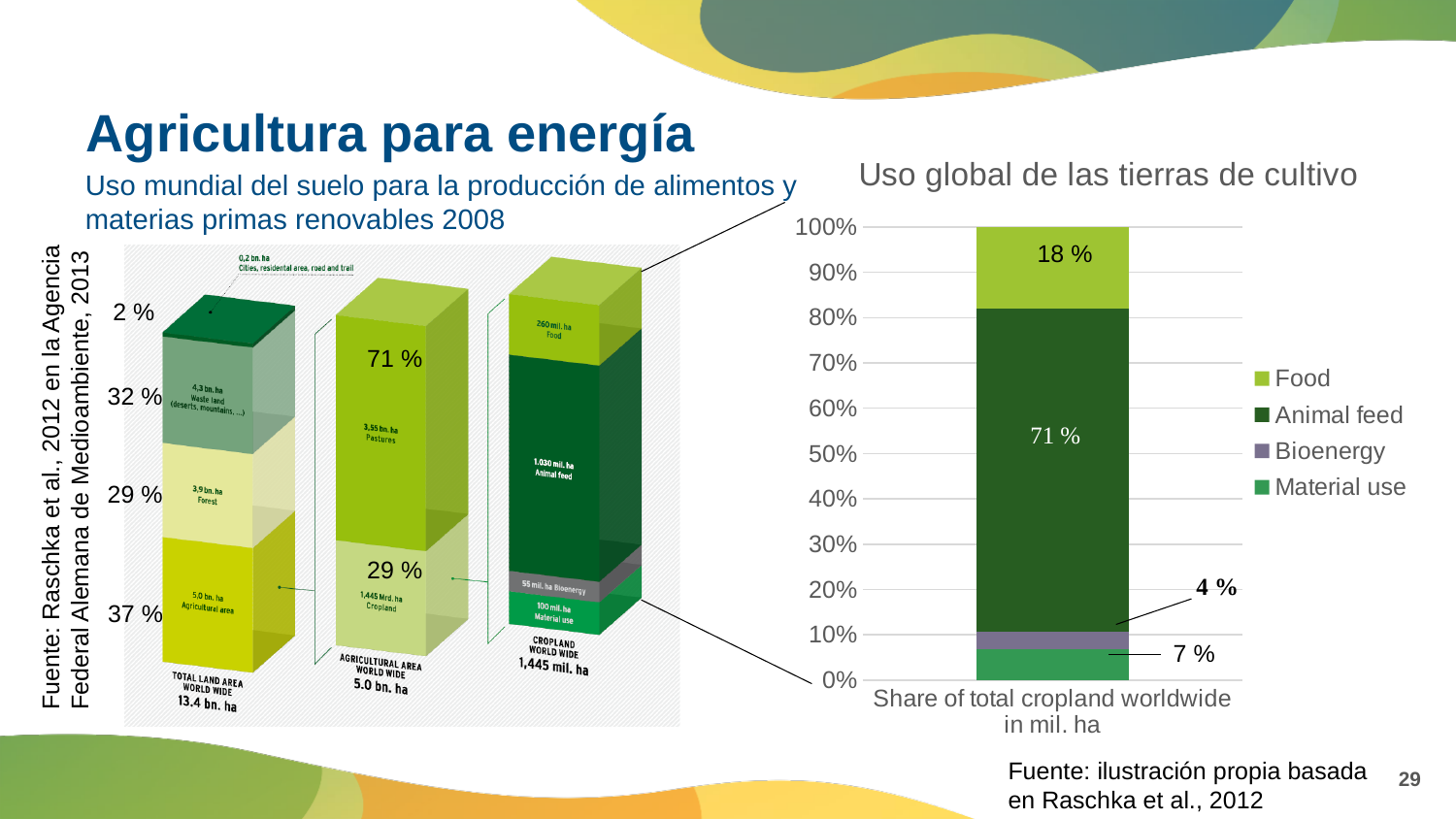
In the chart 'Uso global de las tierras de cultivo', what share of cropland is used for Bioenergy? 4 % In the chart 'Uso global de las tierras de cultivo', how many series does the legend list? 4 In the chart 'Uso global de las tierras de cultivo', which use accounts for the smallest share of cropland? Bioenergy In the chart 'Uso global de las tierras de cultivo', what share of cropland is used for Food? 18 % In the chart 'Uso global de las tierras de cultivo', which is larger, the share for Material use or the share for Bioenergy? Material use In the chart 'Uso global de las tierras de cultivo', how many percentage points larger is the Animal feed share than the Food share? 53 % In the chart 'Uso global de las tierras de cultivo', what share of cropland is used for Material use? 7 % What kind of chart is 'Uso global de las tierras de cultivo'? Stacked bar chart In the chart 'Uso global de las tierras de cultivo', what is the combined share of Bioenergy and Material use? 11 % In the chart 'Uso global de las tierras de cultivo', what is the label shown under the x axis? Share of total cropland worldwide in mil. ha In the chart 'Uso global de las tierras de cultivo', which use accounts for the largest share of cropland? Animal feed In the chart 'Uso global de las tierras de cultivo', what share of cropland is used for Animal feed? 71 %